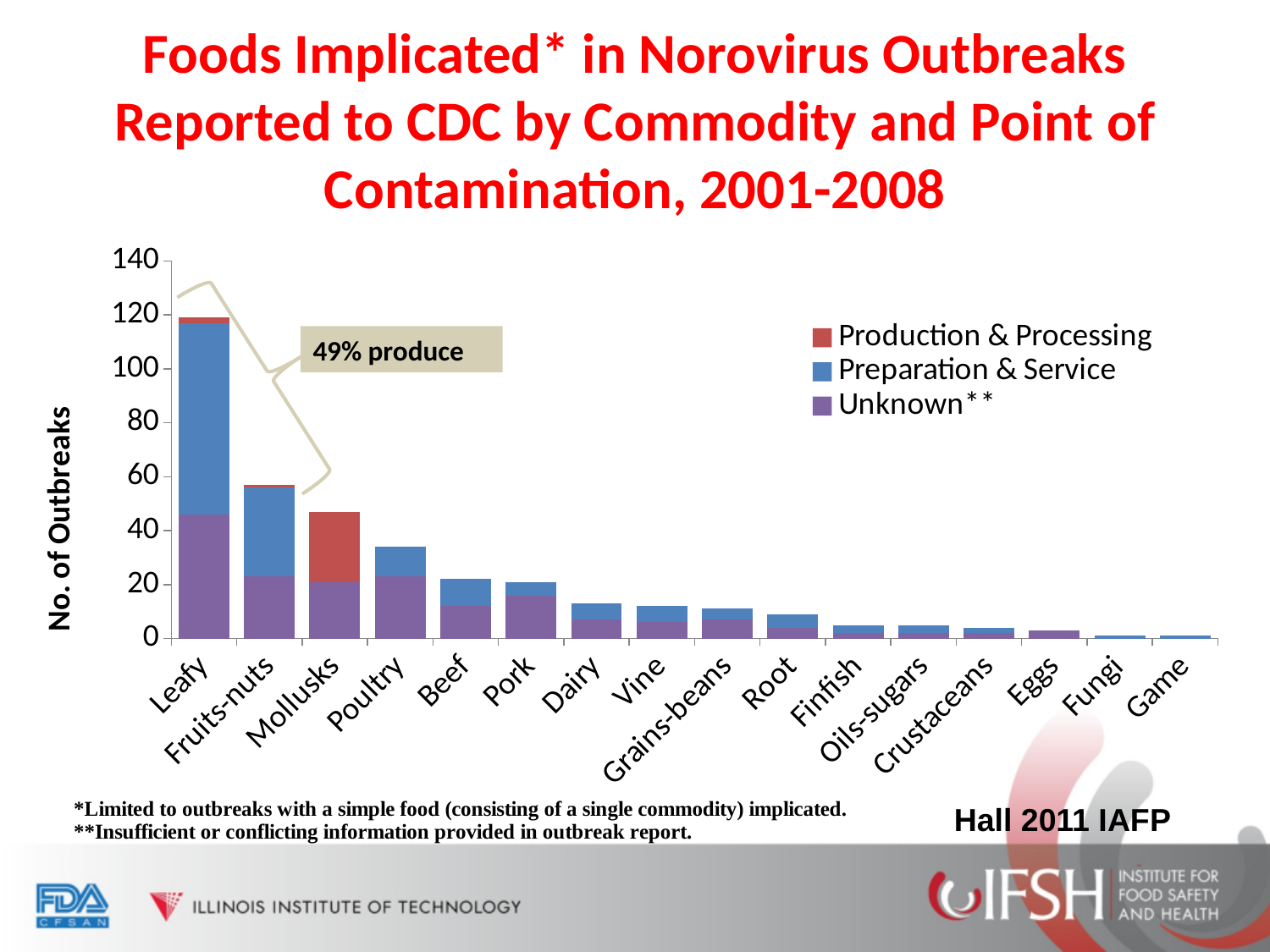
What kind of chart is shown on the slide? Stacked bar chart Is the total number of outbreaks for Poultry greater or less than 40? less Which has more total outbreaks, Mollusks or Poultry? Mollusks Which commodity has the highest total number of outbreaks? Leafy Is the total number of outbreaks for Game greater or less than 20? less Do the total outbreak values rise or fall moving from left to right along the x axis? Fall What percentage does the annotation on the chart attribute to produce? 49% produce Is the total number of outbreaks for Leafy greater or less than 100? greater How many series does the legend list? 3 How many food commodity categories are shown on the x axis? 16 Which has more total outbreaks, Leafy or Fruits-nuts? Leafy